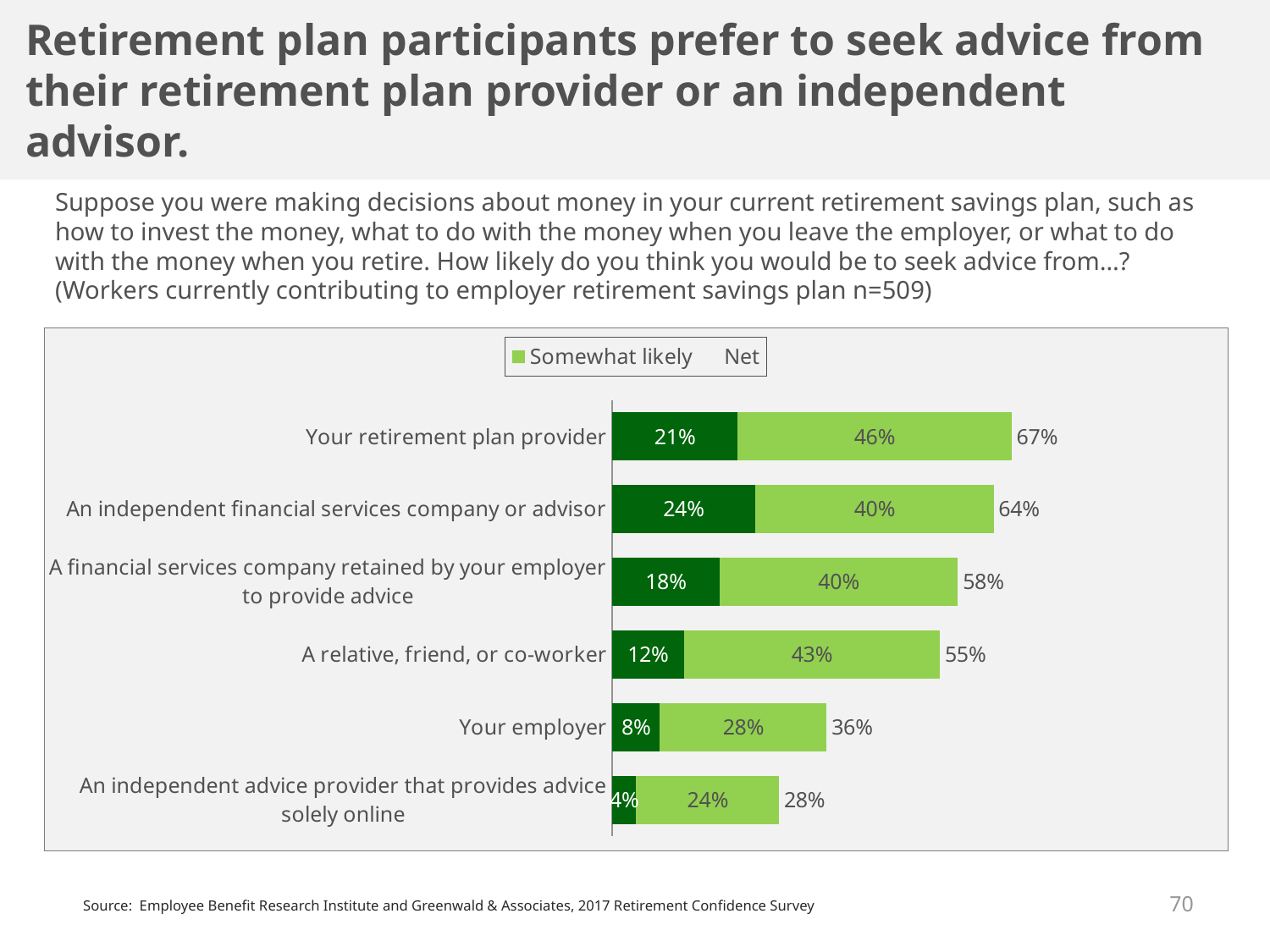
Which category has the highest Net value? Your retirement plan provider What is the difference between the "Somewhat likely" values for "Your employer" and "An independent advice provider that provides advice solely online"? 4% Which legend entry is marked with a light green square? Somewhat likely What is the "Somewhat likely" value for "An independent advice provider that provides advice solely online"? 24% Which category has the lowest Net value? An independent advice provider that provides advice solely online What kind of chart is shown on the slide? Stacked bar chart Which has a larger "Somewhat likely" value: "A relative, friend, or co-worker" or "A financial services company retained by your employer to provide advice"? A relative, friend, or co-worker What is the difference between the Net values for "Your retirement plan provider" and "An independent financial services company or advisor"? 3% What is the total of the stacked bar for "A relative, friend, or co-worker"? 55% What is the "Somewhat likely" value for "Your retirement plan provider"? 46% How many categories are shown in the chart? 6 What is the Net value for "Your employer"? 36%